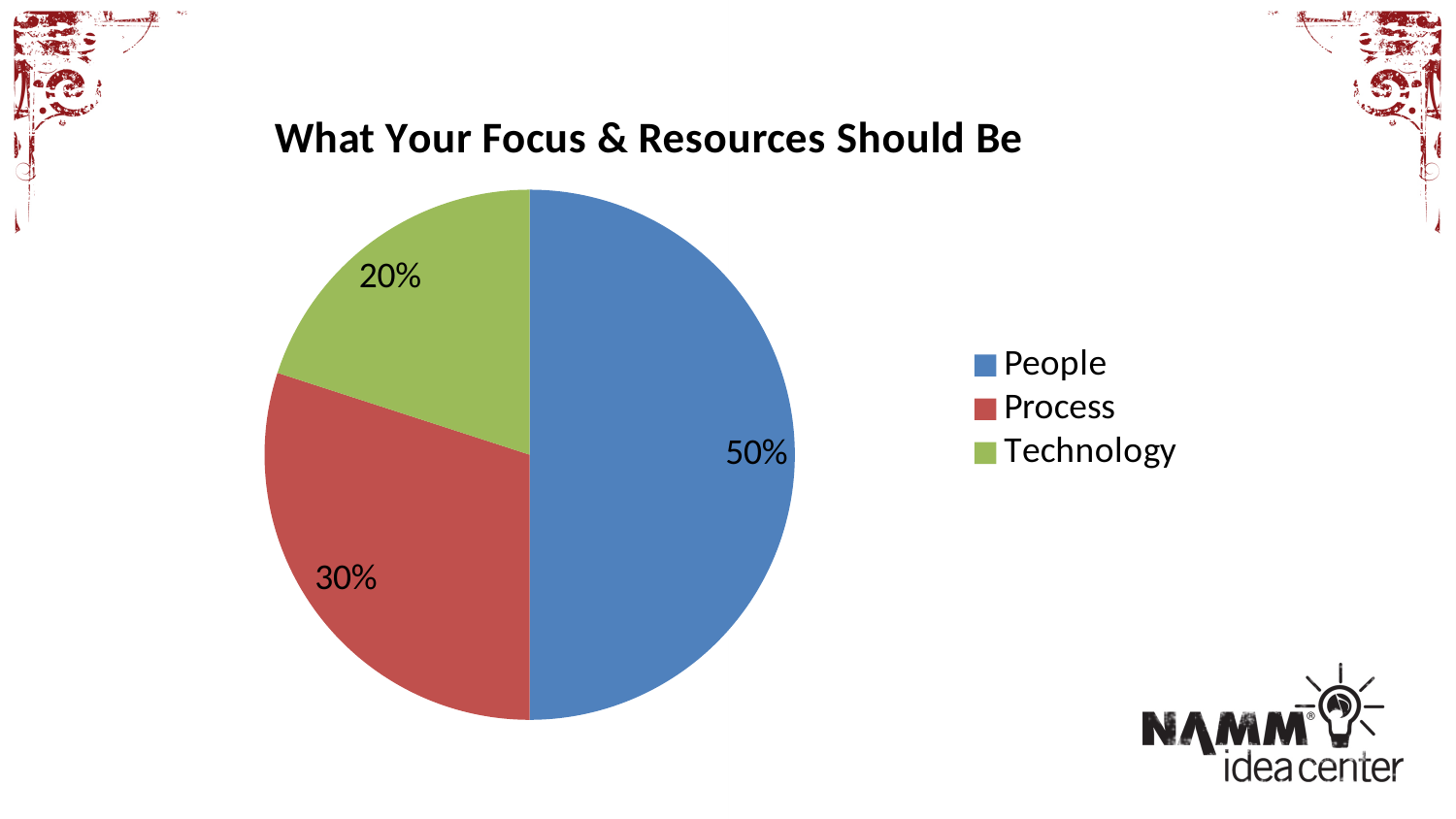
Which category has the largest share of the pie? People How many categories does the pie chart have? 3 What is the difference in percentage points between Process and Technology? 10 Which is larger, the share for Process or the share for Technology? Process What percentage of the pie is Process? 30% What is the difference in percentage points between People and Technology? 30 What percentage of the pie is Technology? 20% What type of chart is shown on the slide? pie chart Which category has the smallest share of the pie? Technology What colour is the People slice? blue What percentage of the pie is People? 50% What is the title of the chart? What Your Focus & Resources Should Be